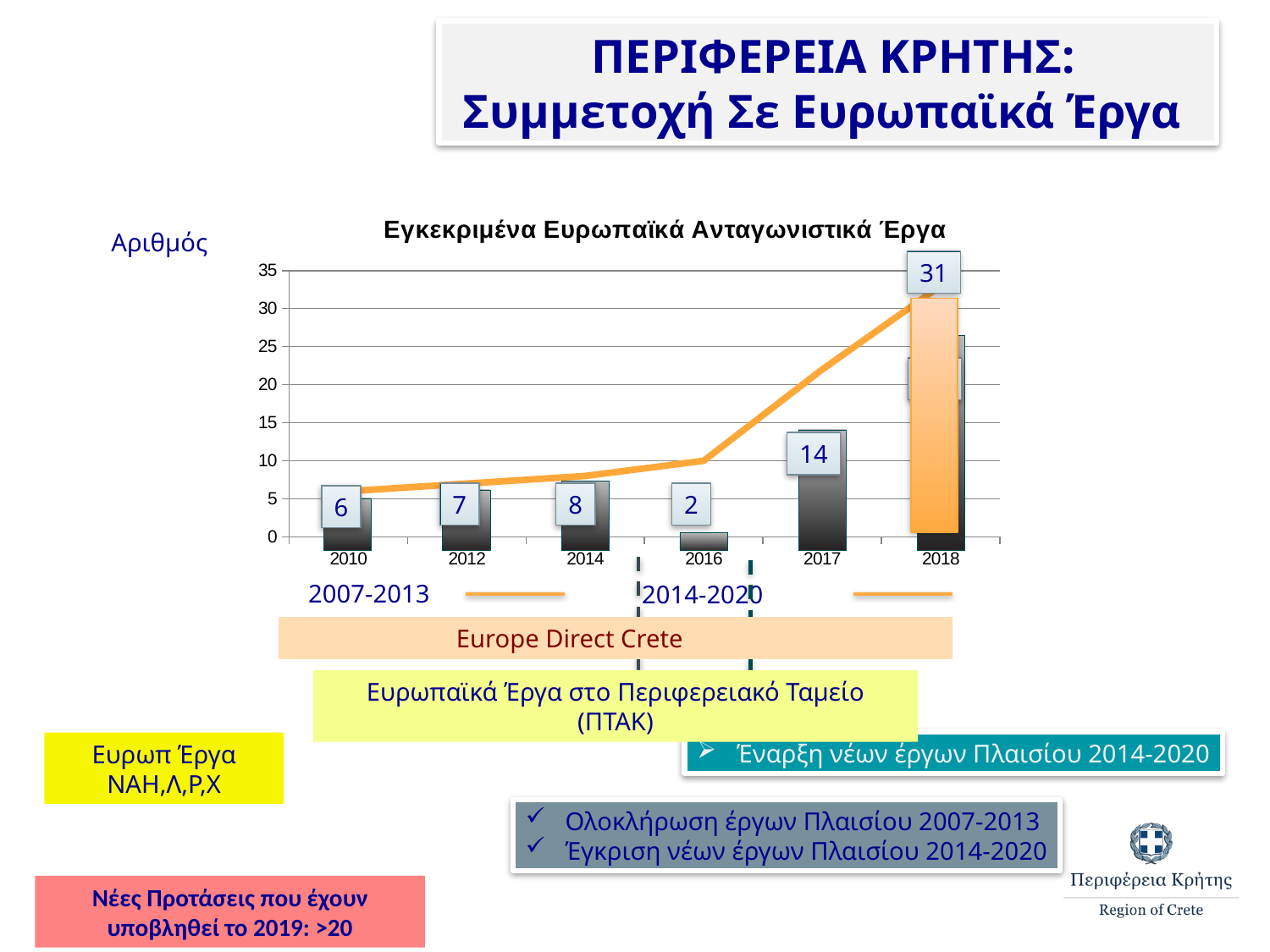
What is the title of the chart on the slide? Εγκεκριμένα Ευρωπαϊκά Ανταγωνιστικά Έργα Which year has the highest value in the chart? 2018 Which year has the larger value, 2014 or 2017? 2017 What is the difference between the values for 2018 and 2017? 17 How many years are shown on the x axis of the chart? 6 Is the value for 2017 greater or less than 10? greater What is the difference between the values for 2014 and 2010? 2 Which year has the lowest value in the chart? 2016 What kind of chart is shown on the slide? a combination bar and line chart What is the value for 2016 in the chart? 2 What is the value for 2018 in the chart? 31 What is the value for 2012 in the chart? 7